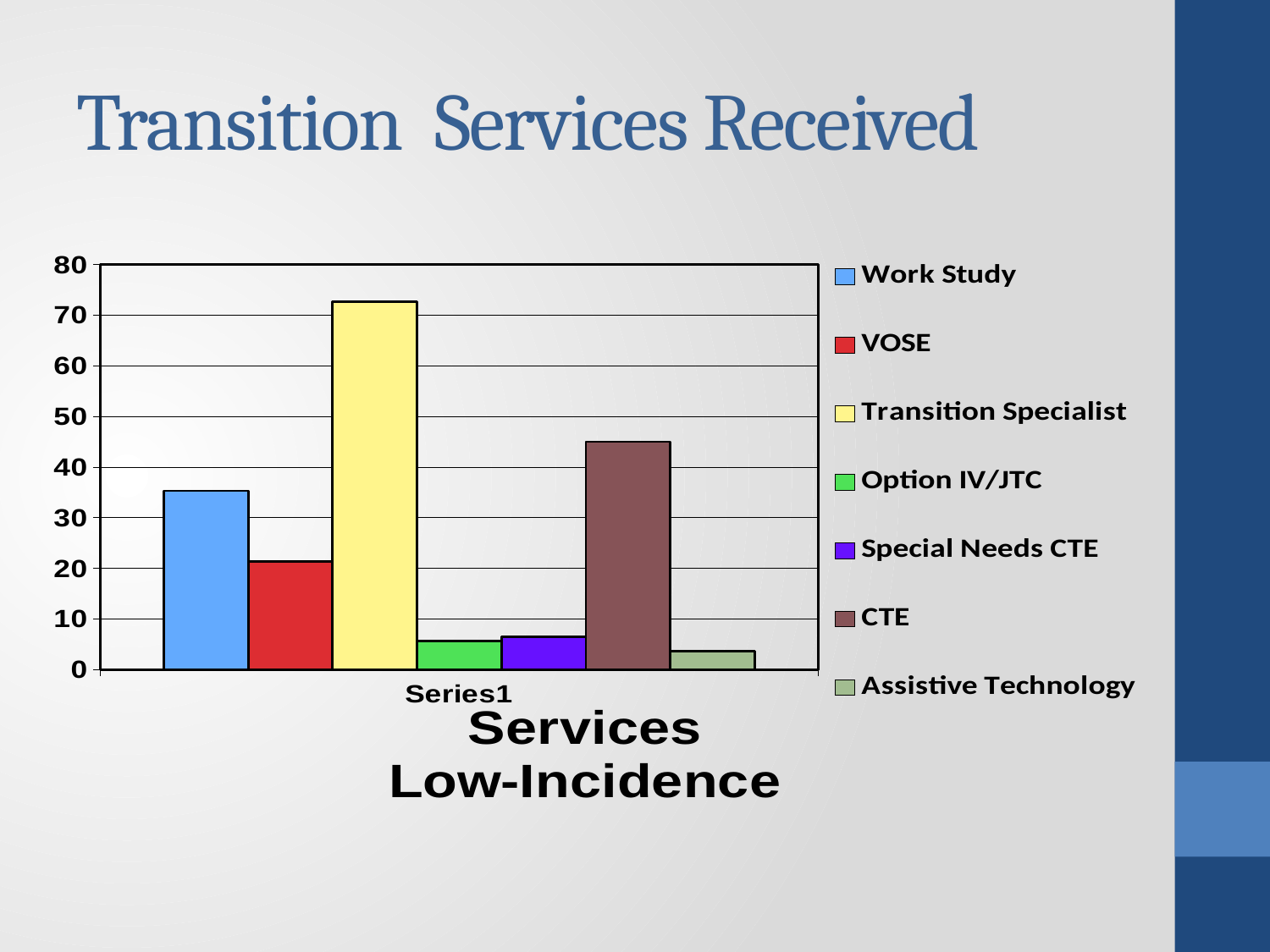
What colour is the bar for Transition Specialist? yellow Is the value for Work Study greater or less than 30? greater Is the value for Transition Specialist greater or less than 70? greater Which is larger, the value for CTE or the value for Work Study? CTE What kind of chart is shown on the slide? bar chart Is the value for CTE greater or less than 50? less What is the label shown below the x axis of the chart? Services Low-Incidence Which service has the highest bar? Transition Specialist Which is larger, the value for VOSE or the value for Work Study? Work Study How many series does the legend list? 7